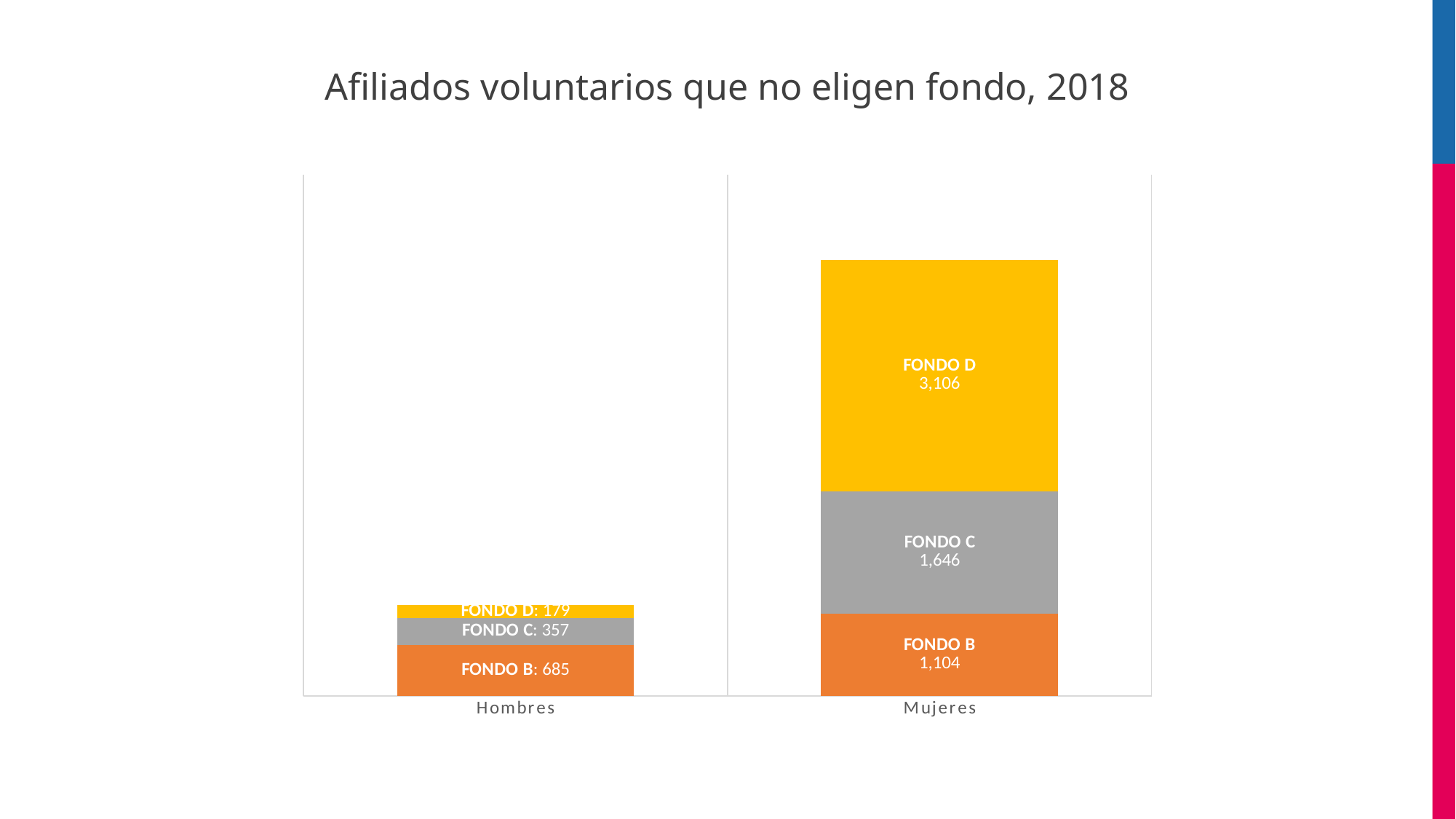
Which is larger: FONDO C for Hombres or FONDO C for Mujeres? FONDO C for Mujeres What is the value for FONDO D in the Hombres bar? 179 Which fund segment is the smallest in the Hombres bar? FONDO D Which fund segment is the largest in the Mujeres bar? FONDO D What is the value for FONDO C in the Mujeres bar? 1,646 What type of chart is shown on the slide? Stacked bar chart What is the total of the Mujeres stacked bar? 5,856 What is the total of the Hombres stacked bar? 1,221 How many categories are shown on the x axis? 2 What is the difference between FONDO B for Mujeres and FONDO B for Hombres? 419 What is the value for FONDO D in the Mujeres bar? 3,106 What is the value for FONDO B in the Hombres bar? 685